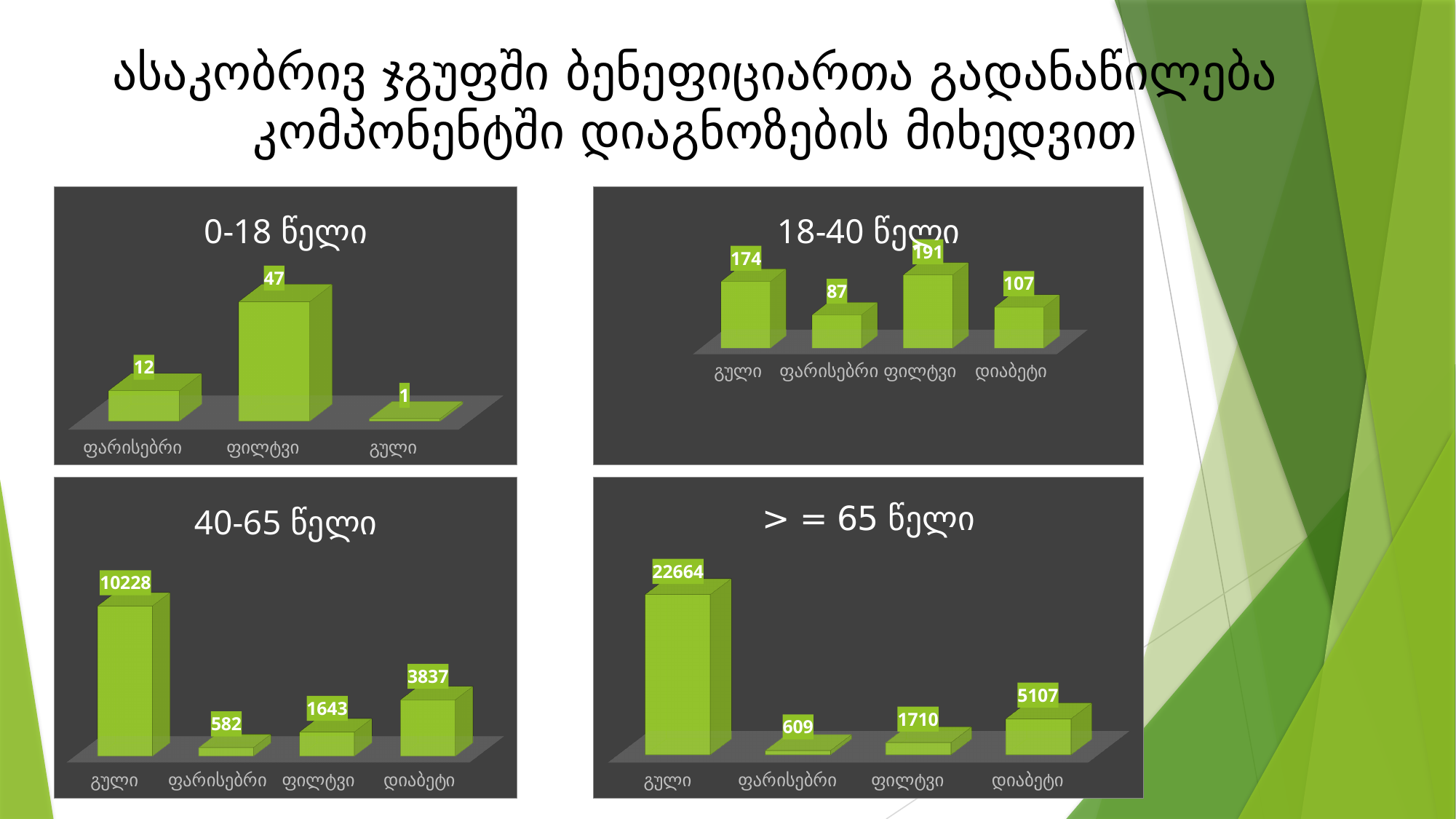
In the "40-65 წელი" chart, which is larger, ფილტვი or დიაბეტი? დიაბეტი What type of chart is used in the "> = 65 წელი" chart? Bar chart In the "0-18 წელი" chart, what is the value for ფილტვი? 47 In the "0-18 წელი" chart, how many categories are shown? 3 In the "0-18 წელი" chart, which category has the lowest value? გული In the "40-65 წელი" chart, what is the value for ფარისებრი? 582 In the "18-40 წელი" chart, what is the difference between გული and ფარისებრი? 87 In the "> = 65 წელი" chart, which category has the lowest value? ფარისებრი In the "> = 65 წელი" chart, what is the value for გული? 22664 In the "18-40 წელი" chart, which category has the highest value? ფილტვი In the "40-65 წელი" chart, what is the difference between გული and დიაბეტი? 6391 In the "18-40 წელი" chart, what is the value for დიაბეტი? 107